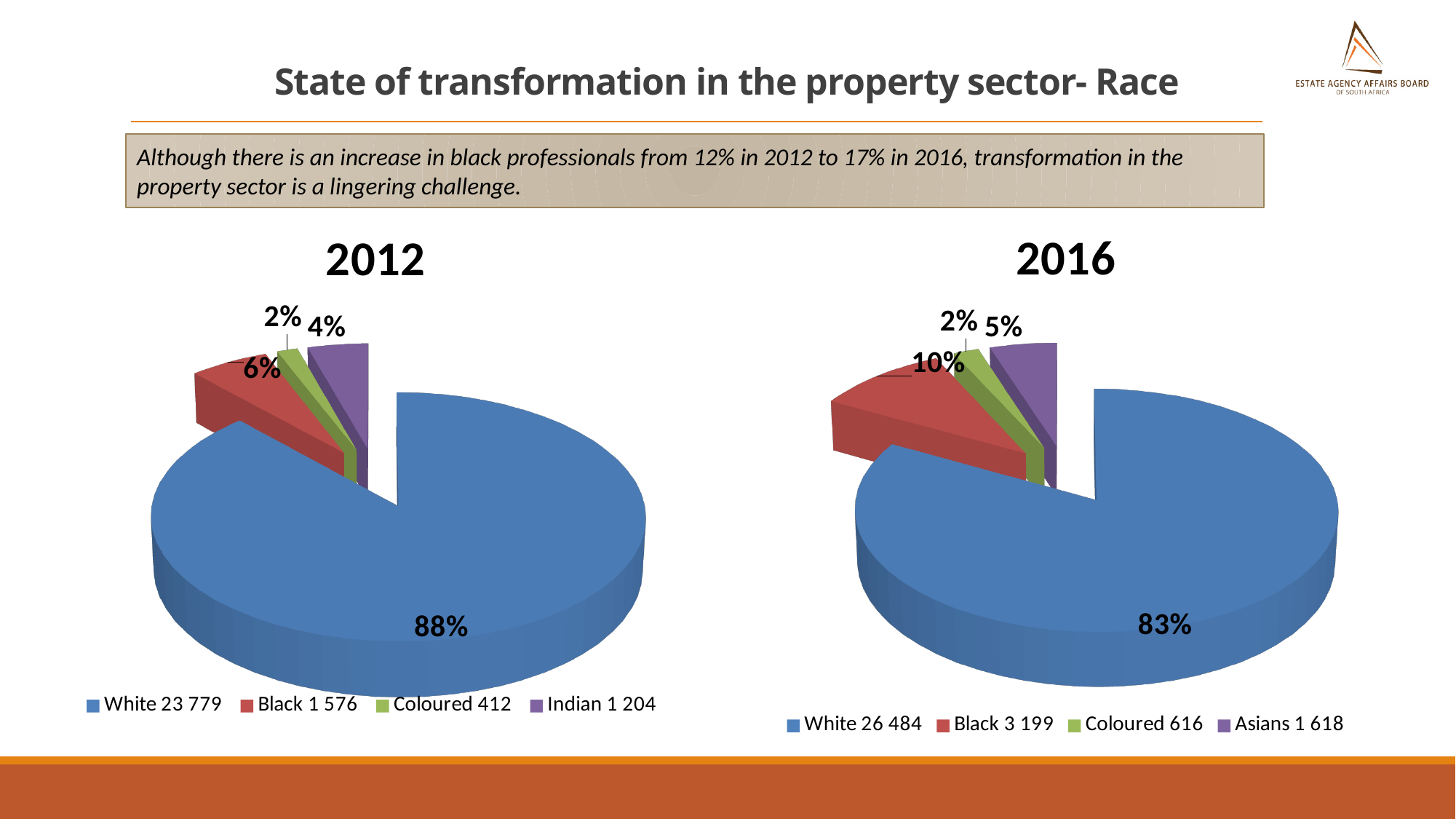
What type of chart is used for the 2012 data? pie chart In the 2012 pie chart, which category has the smallest share? Coloured In the 2012 pie chart, what percentage share does the Indian category have? 4% What is the difference in percentage points between the White share in the 2012 pie chart and the White share in the 2016 pie chart? 5% According to the legend of the 2016 pie chart, what is the value for Coloured? 616 How many categories does the legend of the 2016 pie chart list? 4 In the 2012 pie chart, what percentage share does the White category have? 88% In the 2016 pie chart, what percentage share does the Black category have? 10% According to the legend of the 2012 pie chart, what is the value for Black? 1 576 In the 2016 pie chart, which category has the largest share? White In the 2016 pie chart, is the share for Black larger or smaller than the share for Asians? larger